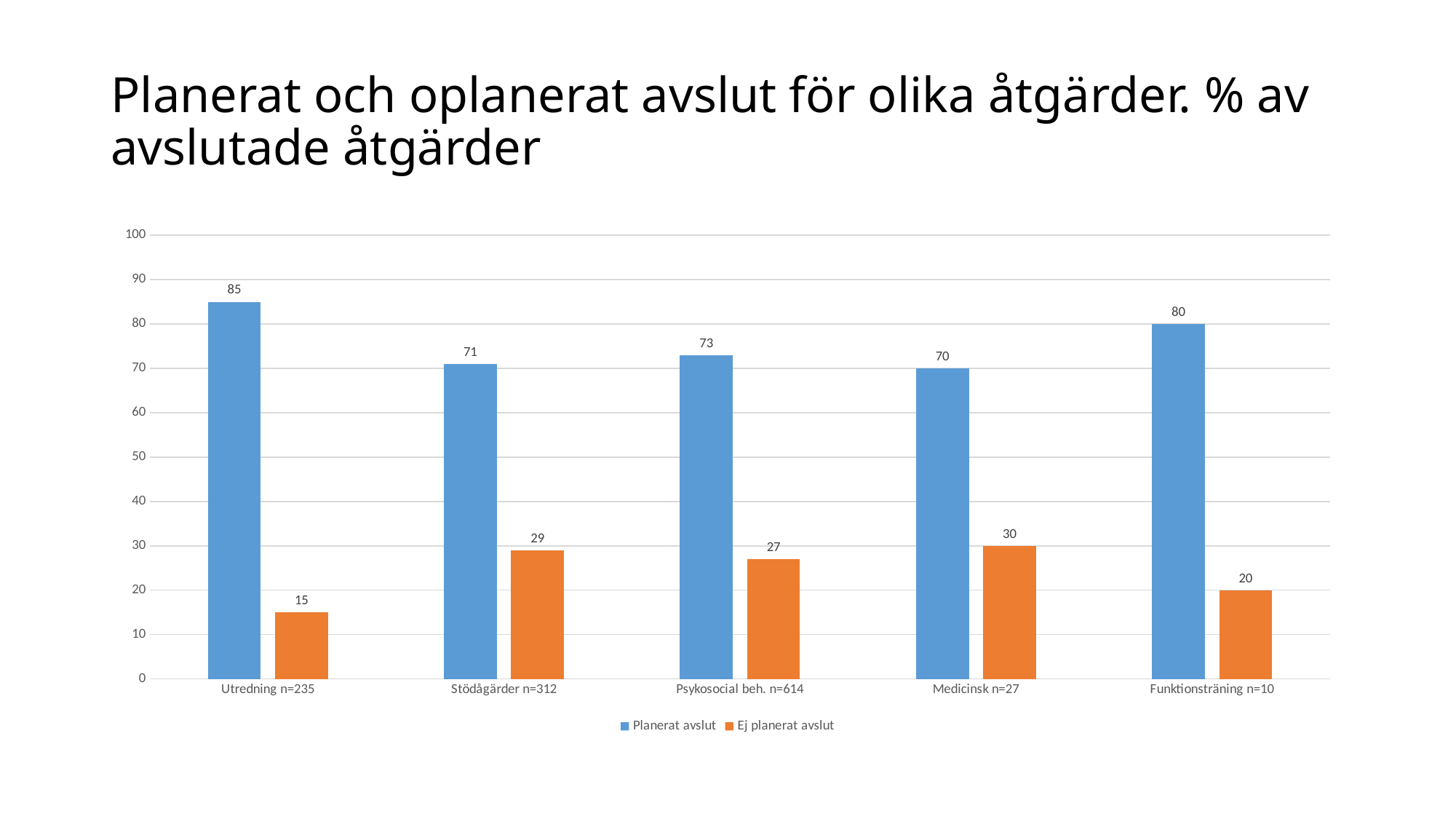
What is the value of Planerat avslut for Utredning n=235? 85 Which category has the highest value for Planerat avslut? Utredning n=235 Is the value of Planerat avslut for Funktionsträning n=10 greater or less than 50? greater How many series does the legend list? 2 What colour are the bars for Ej planerat avslut? Orange What kind of chart is shown on the slide? Bar chart How many categories are shown on the x axis? 5 What is the value of Ej planerat avslut for Medicinsk n=27? 30 Which category has the lowest value for Ej planerat avslut? Utredning n=235 Which is larger: Planerat avslut for Psykosocial beh. n=614 or Planerat avslut for Medicinsk n=27? Psykosocial beh. n=614 What is the value of Ej planerat avslut for Funktionsträning n=10? 20 What is the difference between Planerat avslut and Ej planerat avslut for Stödågärder n=312? 42